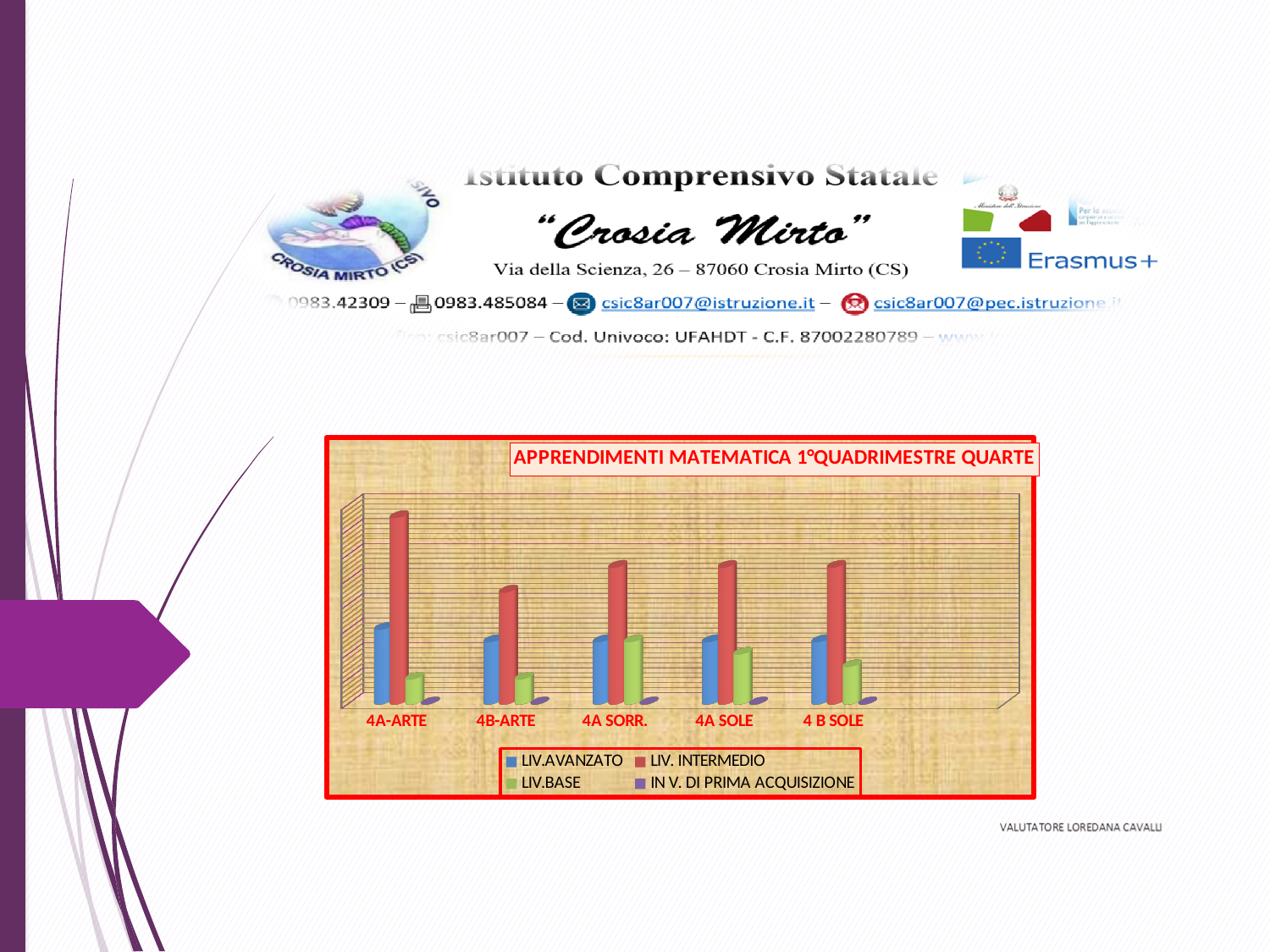
Which series has the smallest bar in every class? IN V. DI PRIMA ACQUISIZIONE Which class has the lowest LIV. INTERMEDIO bar? 4B-ARTE What is the title of the chart? APPRENDIMENTI MATEMATICA 1°QUADRIMESTRE QUARTE What kind of chart is shown on the slide? bar chart How many series does the chart legend list? 4 How many classes (categories) are shown on the x axis of the chart? 5 Which class has the highest LIV. INTERMEDIO bar? 4A-ARTE Which series is shown in red in the chart? LIV. INTERMEDIO For 4B-ARTE, which is larger: LIV.AVANZATO or LIV.BASE? LIV.AVANZATO Which class has the highest LIV.BASE bar? 4A SORR. For 4A-ARTE, which is larger: LIV.AVANZATO or LIV. INTERMEDIO? LIV. INTERMEDIO Which series has the tallest bar in every class? LIV. INTERMEDIO